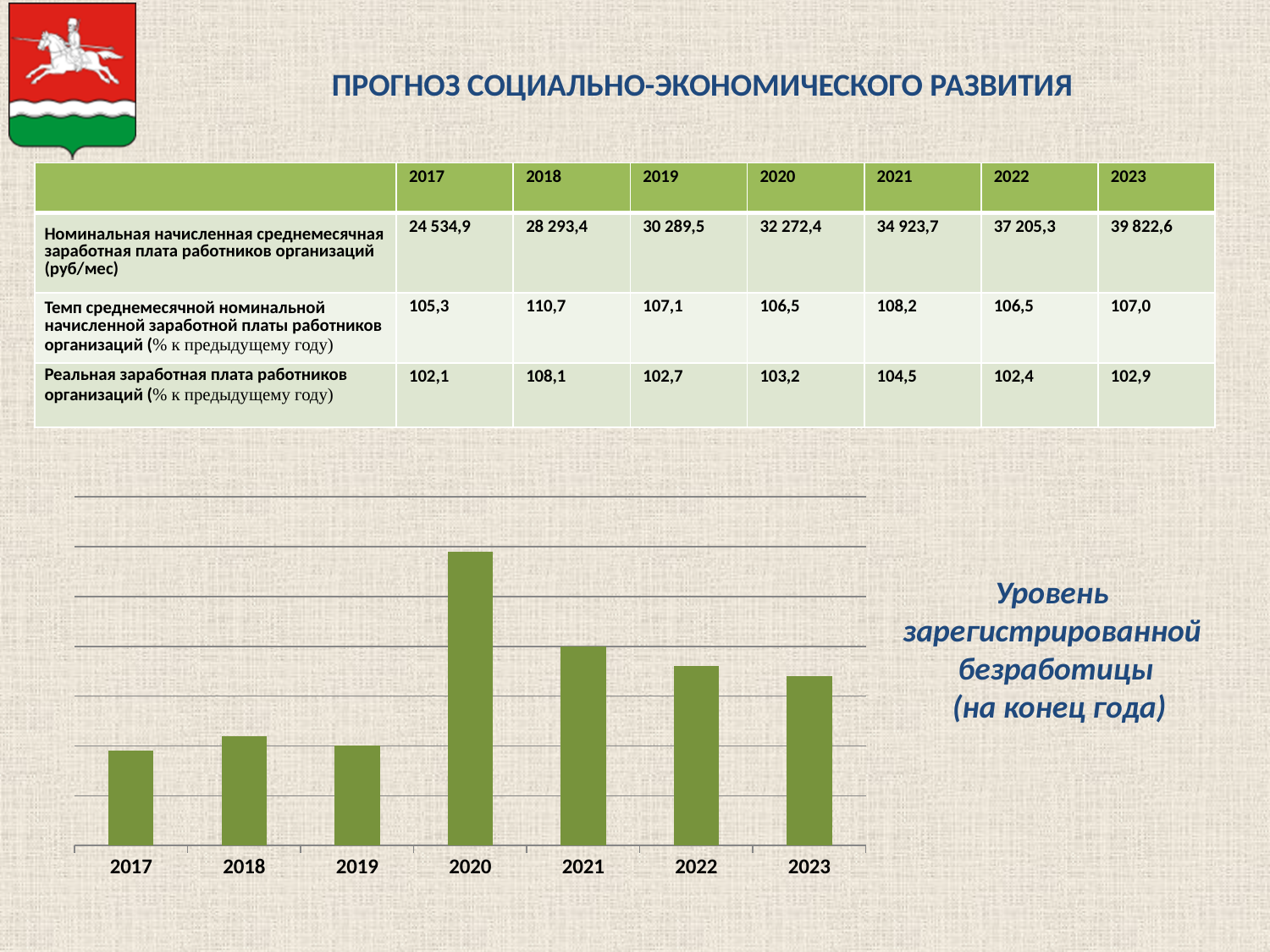
Which bar is taller in the chart, 2017 or 2018? 2018 Which bar is taller in the chart, 2018 or 2021? 2021 What is the first year shown on the x axis of the chart? 2017 Which bar is taller in the chart, 2020 or 2021? 2020 Which year has the highest bar in the chart? 2020 What kind of chart is shown at the bottom of the slide? bar chart What is the title of the chart on the slide? Уровень зарегистрированной безработицы (на конец года) Do the bars in the chart rise or fall from 2020 to 2023? fall How many years are shown on the x axis of the chart? 7